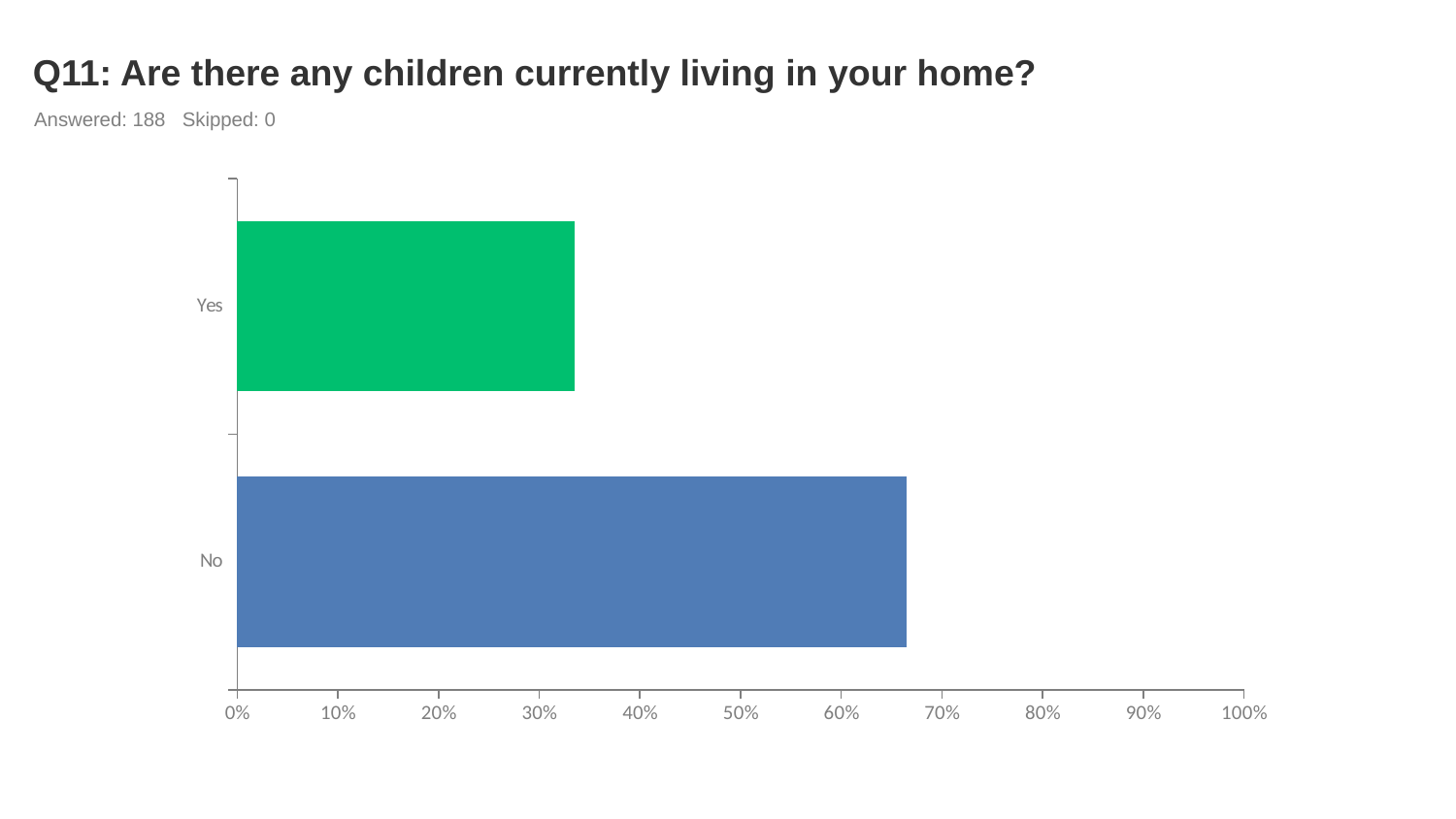
What kind of chart is shown on the slide? bar chart How many categories does the chart show? 2 Which category has the highest value? No Is the value for Yes greater or less than 40%? less What is the title of the chart? Q11: Are there any children currently living in your home? How many respondents answered the question according to the slide? 188 Is the value for Yes greater or less than 30%? greater Is the value for No greater or less than 70%? less Which is larger, the value for Yes or the value for No? No Which category has the lowest value? Yes